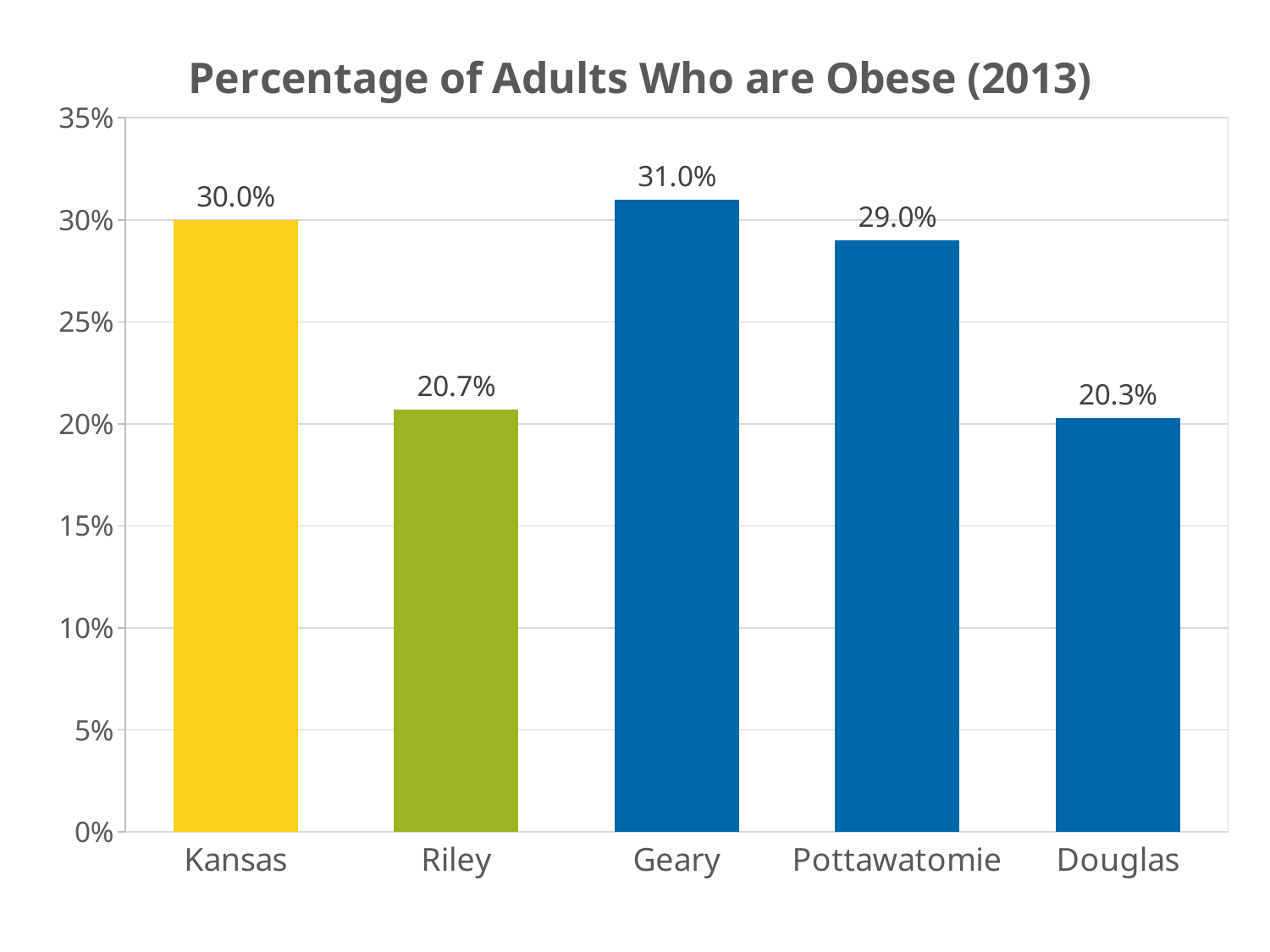
What is the percentage of adults who are obese in Riley? 20.7% What is the title of the chart? Percentage of Adults Who are Obese (2013) What is the difference between the obesity percentages for Kansas and Riley? 9.3% Is the value for Riley greater or less than 25%? less Which has a higher percentage of obese adults, Geary or Pottawatomie? Geary What is the percentage of adults who are obese in Kansas? 30.0% What kind of chart is shown on the slide? Bar chart Which category has the highest percentage of obese adults? Geary What is the difference between the obesity percentages for Geary and Douglas? 10.7% Which category has the lowest percentage of obese adults? Douglas How many categories are shown on the chart? 5 What is the percentage of adults who are obese in Pottawatomie? 29.0%